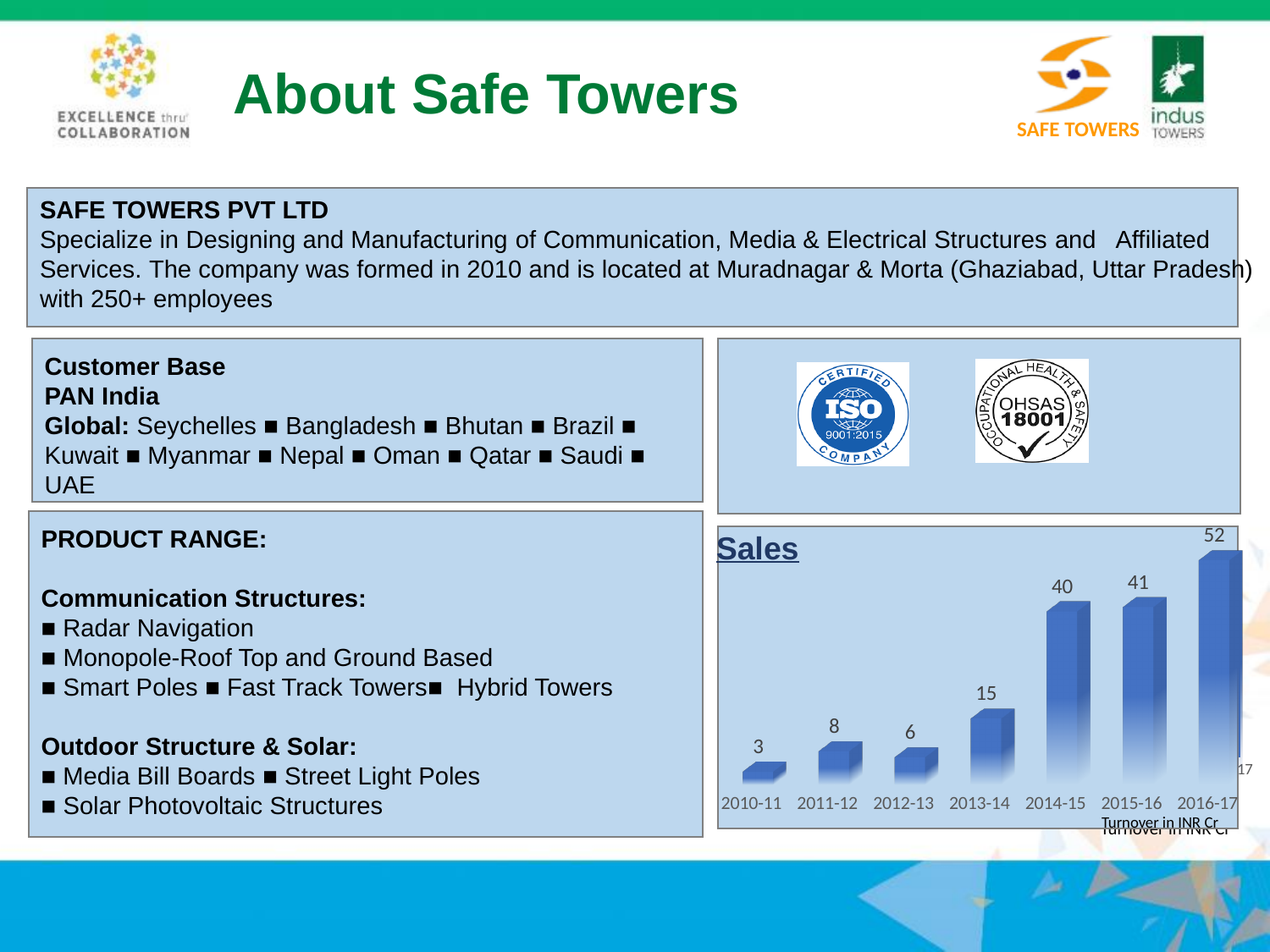
What is the difference between the sales values for 2014-15 and 2013-14? 25 What is the sales value for 2013-14? 15 Which year has the lowest sales value? 2010-11 Do sales values generally rise or fall from 2012-13 to 2016-17? rise Which is larger, the sales value for 2011-12 or 2012-13? 2011-12 How many years are shown in the Sales chart? 7 What is the sales value for 2015-16? 41 What is the title of the chart on the slide? Sales What is the sales value for 2016-17? 52 Which year has the highest sales value? 2016-17 What kind of chart is the Sales chart? bar chart What is the sales value for 2010-11? 3